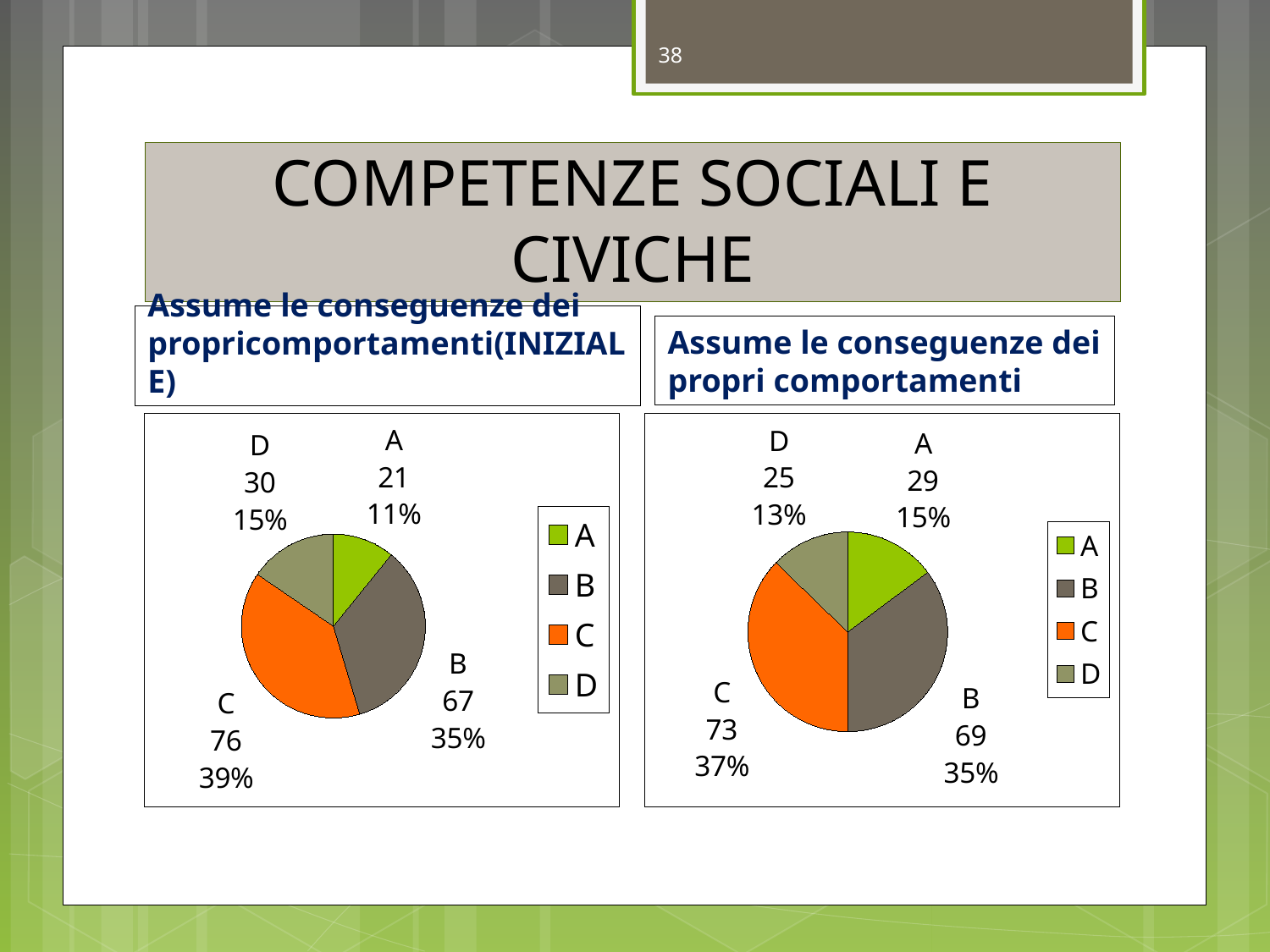
In the left pie chart (INIZIALE), what is the value for category C? 76 What type of chart is shown on the left side of the slide? Pie chart In the left pie chart (INIZIALE), what is the difference between the values for C and B? 9 In the left pie chart (INIZIALE), which category has the largest slice? C In the right pie chart, which category has the smallest slice? D How many slices does the right pie chart have? 4 In the right pie chart, what percentage share does category D have? 13% What is the title of the right chart? Assume le conseguenze dei propri comportamenti How many entries does the legend of the left pie chart list? 4 In the right pie chart, which is larger, the value for A or the value for D? A In the right pie chart, what is the value for category A? 29 In the left pie chart (INIZIALE), what percentage share does category B have? 35%